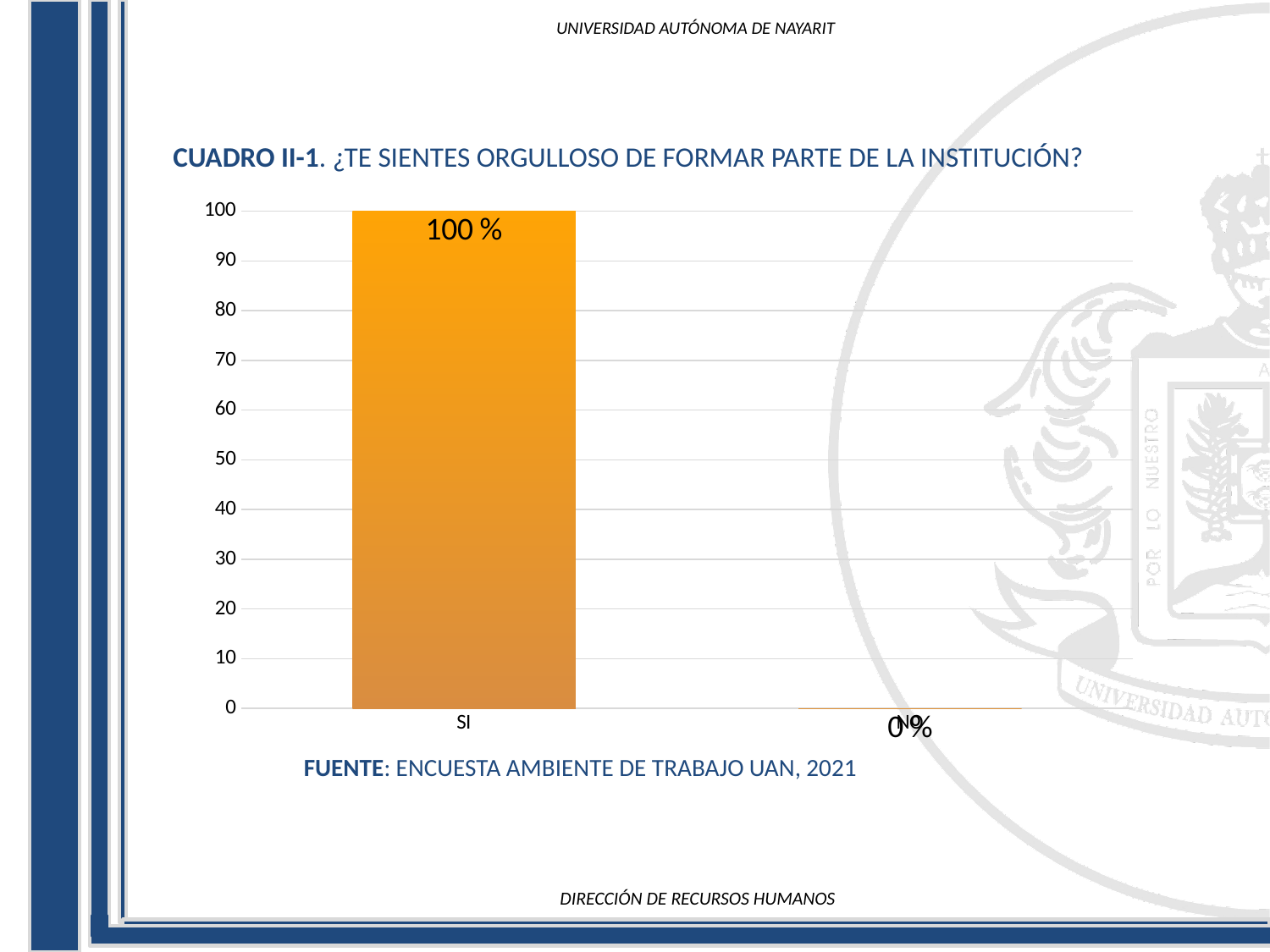
Which category has the highest value? SI What source is cited below the chart? ENCUESTA AMBIENTE DE TRABAJO UAN, 2021 What is the value shown for SI? 100 % Which category has the lowest value? NO What is the maximum value shown on the vertical axis? 100 What is the value shown for NO? 0% Is the value for SI greater or less than 50? greater What is the difference between the values for SI and NO? 100 % How many categories are shown on the x axis? 2 What kind of chart is shown on the slide? bar chart Which is larger, the value for SI or the value for NO? SI